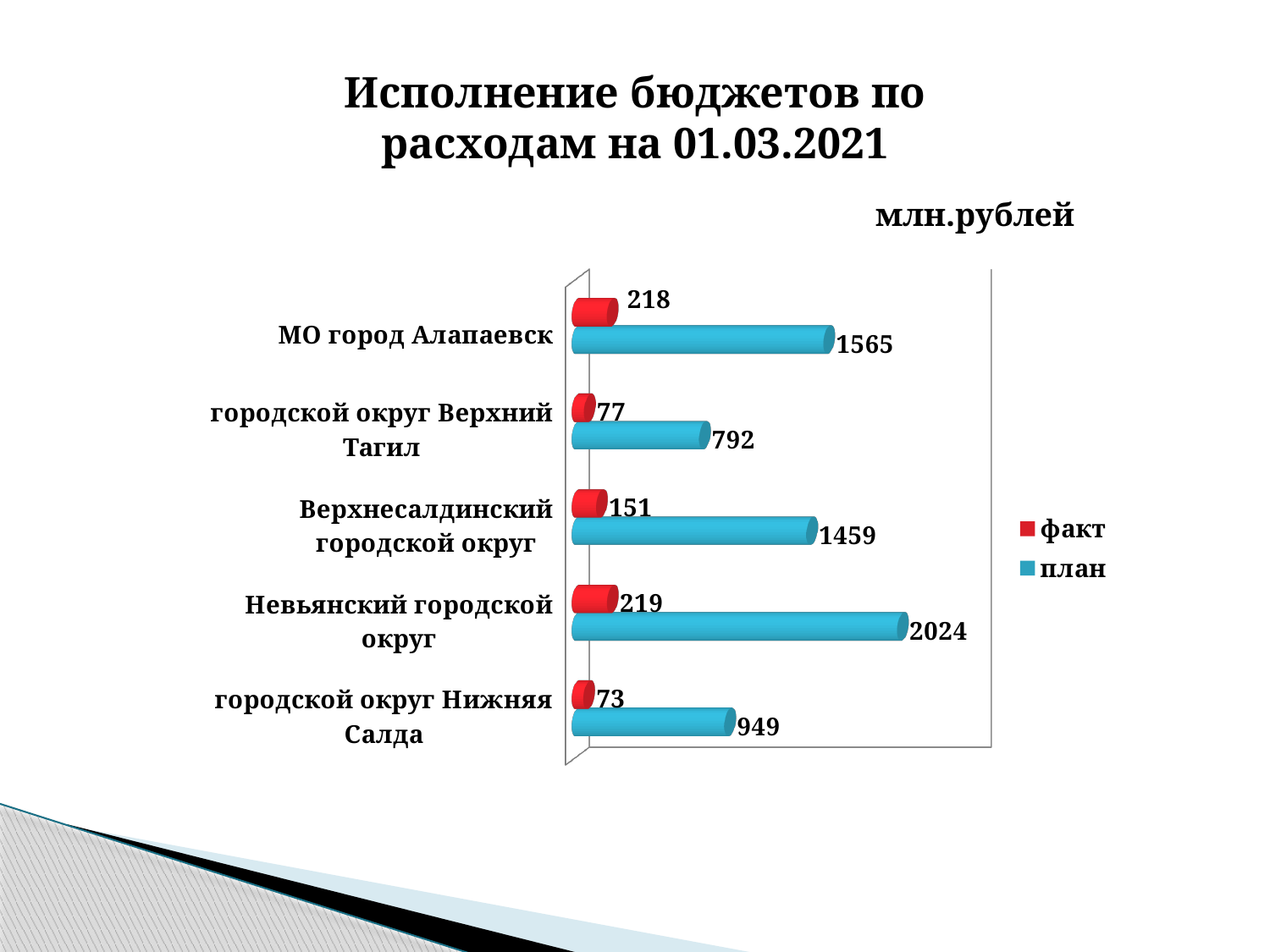
What is the difference between the план and факт values for Верхнесалдинский городской округ? 1308 What is the план value for Невьянский городской округ? 2024 Which category has the lowest факт value? городской округ Нижняя Салда What is the факт value for МО город Алапаевск? 218 How many categories are shown on the chart? 5 How many series does the legend list? 2 What unit is stated above the chart? млн.рублей What kind of chart is shown on the slide? Bar chart What is the факт value for городской округ Нижняя Салда? 73 Which is larger, the план value for МО город Алапаевск or the план value for Верхнесалдинский городской округ? МО город Алапаевск What is the план value for городской округ Верхний Тагил? 792 Which category has the highest план value? Невьянский городской округ